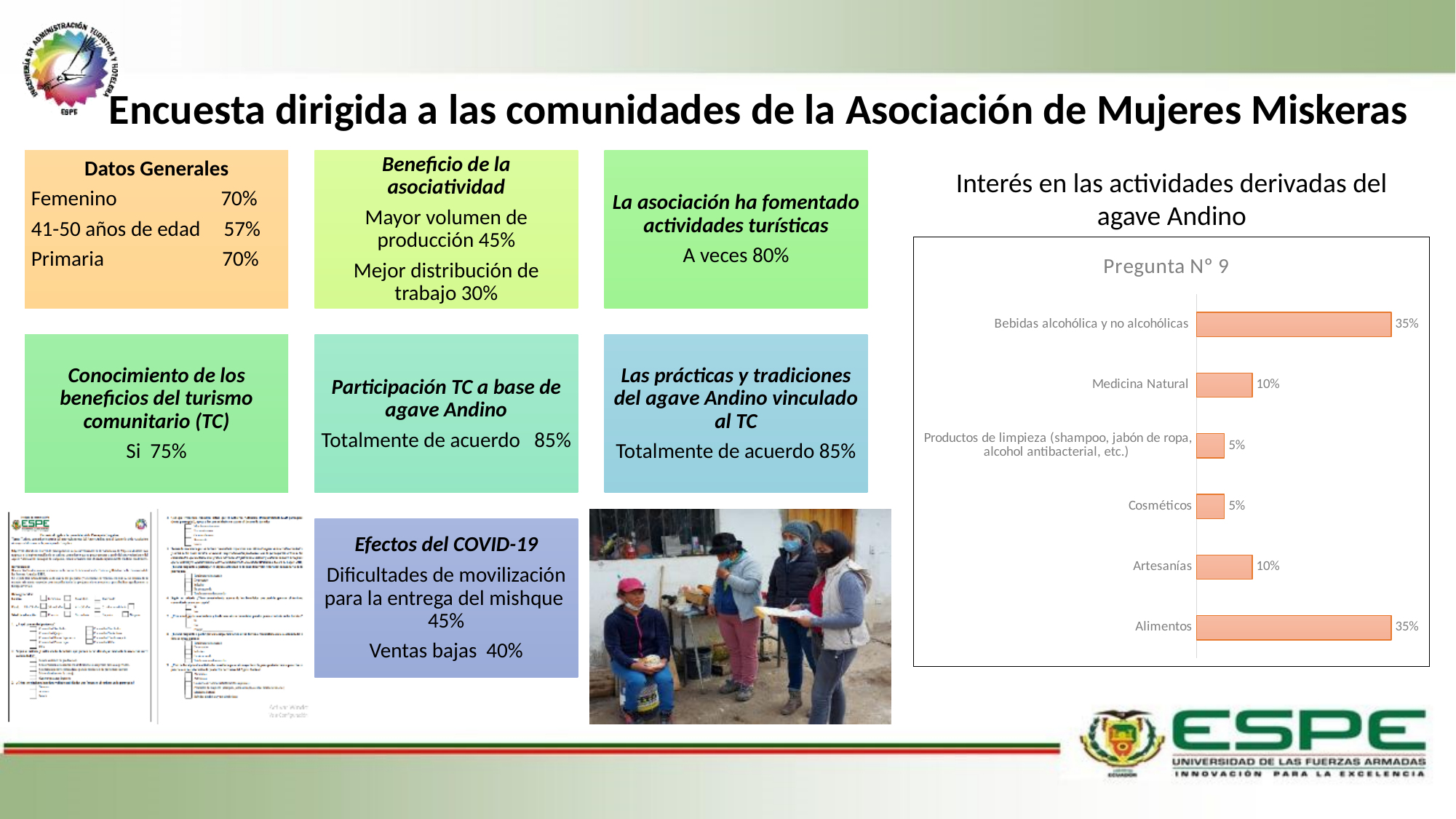
What is the total of the values for Bebidas alcohólica y no alcohólicas and Alimentos? 70% What is the difference between the values for Artesanías and Cosméticos? 5% How many categories are shown in the chart? 6 What is the value for Medicina Natural in the chart? 10% Is the value for Alimentos larger than the value for Artesanías? Yes What is the value for Alimentos in the chart? 35% What kind of chart is shown on the slide? Bar chart What is the difference between the values for Bebidas alcohólica y no alcohólicas and Medicina Natural? 25% What is the value for Cosméticos in the chart? 5% What is the value for Artesanías in the chart? 10% What is the title shown inside the chart area? Pregunta N° 9 Which category has the lowest value in the chart, Medicina Natural or Cosméticos? Cosméticos